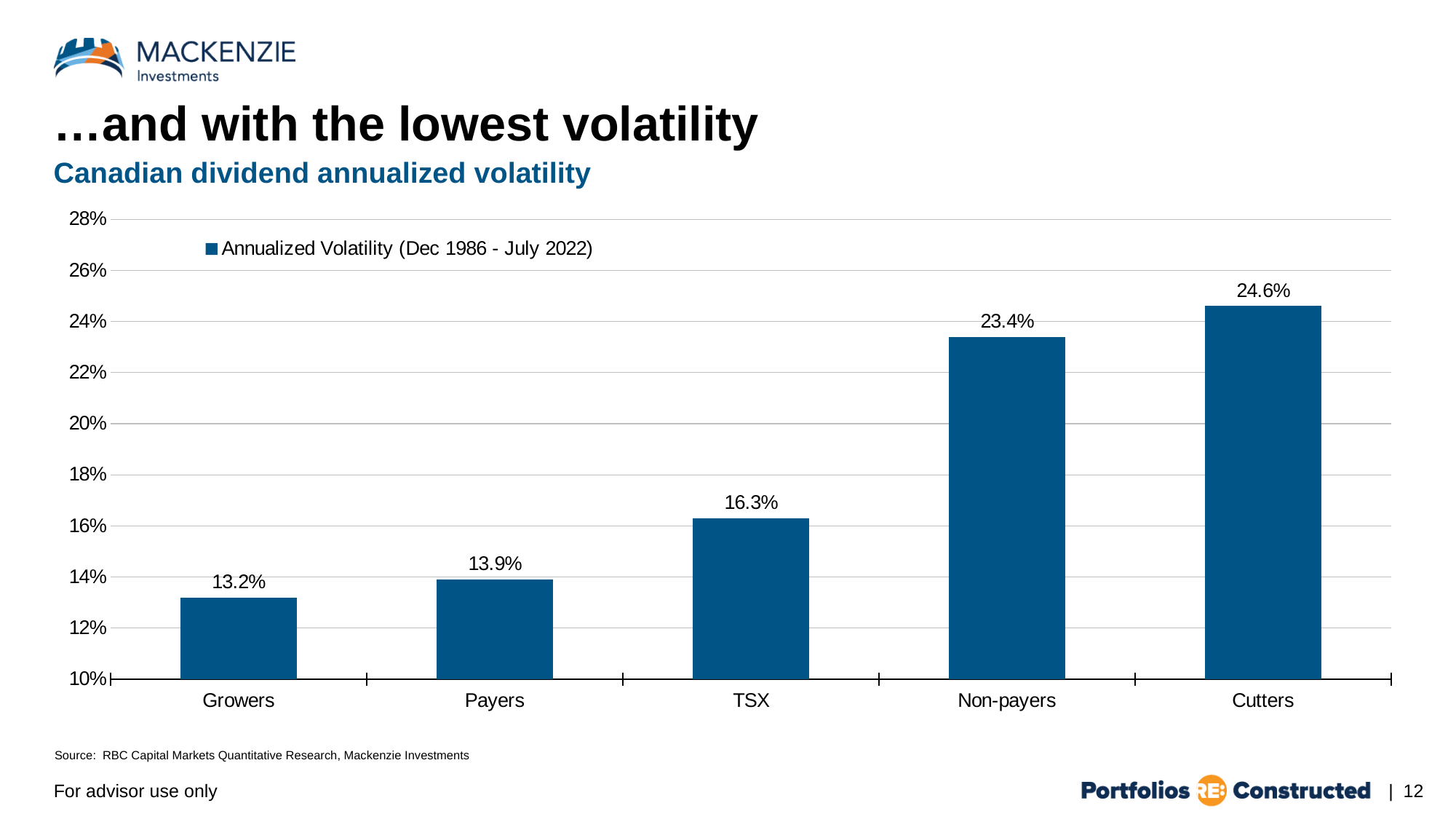
Which category has the highest annualized volatility? Cutters What is the legend entry for the series shown in the chart? Annualized Volatility (Dec 1986 - July 2022) How many categories are shown on the x axis? 5 What is the annualized volatility for Growers? 13.2% What is the annualized volatility for Non-payers? 23.4% What is the difference in annualized volatility between Payers and Growers? 0.7% Is the value for Non-payers greater or less than 22%? greater What is the annualized volatility for TSX? 16.3% What is the difference in annualized volatility between Cutters and Growers? 11.4% Which has a higher annualized volatility, TSX or Payers? TSX Which category has the lowest annualized volatility? Growers What kind of chart is shown on the slide? Bar chart